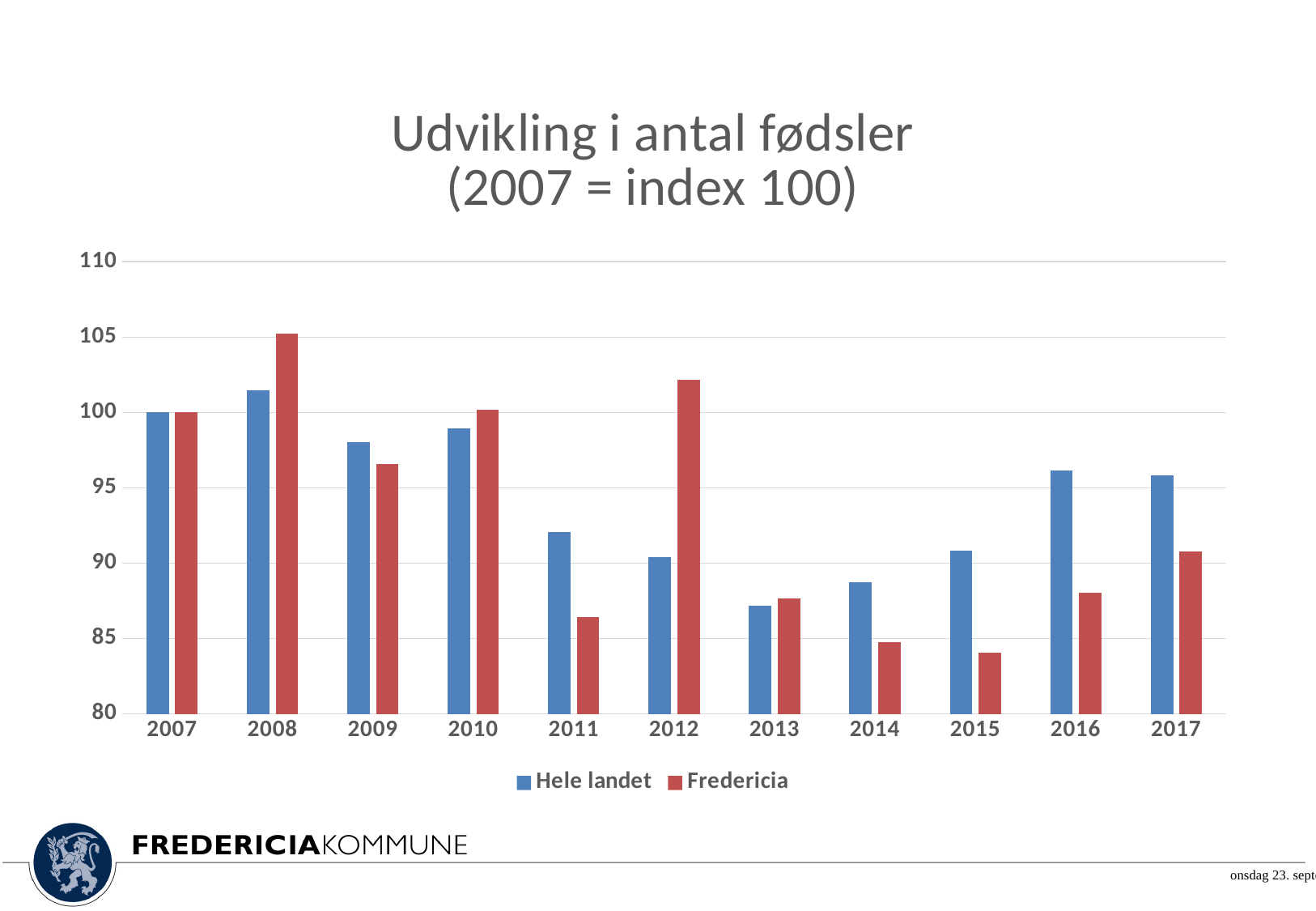
In which year is the Fredericia value lowest? 2015 In 2012, which is larger: Hele landet or Fredericia? Fredericia What kind of chart is shown on the slide? bar chart What is the title of the chart? Udvikling i antal fødsler (2007 = index 100) How many years are shown on the x axis? 11 What is the value for Hele landet in 2007? 100 In which year is the Hele landet value lowest? 2013 Is the value for Fredericia in 2011 greater or less than 90? less In which year is the Fredericia value highest? 2008 What is the value for Fredericia in 2007? 100 How many series does the legend list? 2 Is the value for Hele landet in 2016 greater or less than 95? greater